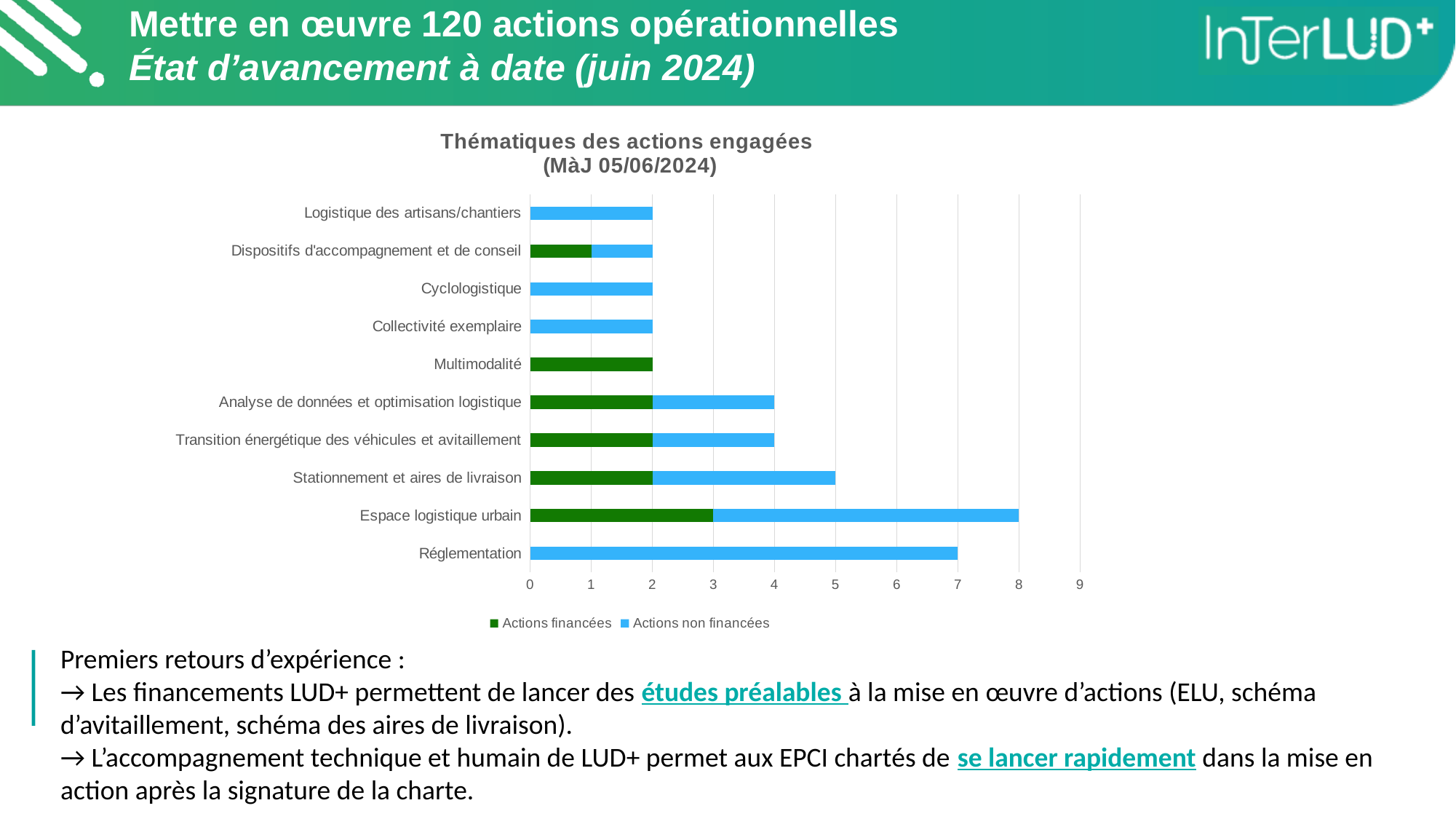
Is the total bar for Réglementation greater or less than 5? greater What is the value of Actions financées for Espace logistique urbain? 3 How many series does the legend list? 2 Which has a longer total bar, Stationnement et aires de livraison or Multimodalité? Stationnement et aires de livraison Which category has the longest total bar? Espace logistique urbain What is the value of Actions financées for Dispositifs d'accompagnement et de conseil? 1 What is the total length of the bar for Réglementation? 7 How many thematic categories are plotted on the chart? 10 What is the total length of the bar for Stationnement et aires de livraison? 5 What is the total length of the bar for Espace logistique urbain? 8 What kind of chart is shown on the slide? Stacked bar chart What is the title of the chart? Thématiques des actions engagées (MàJ 05/06/2024)